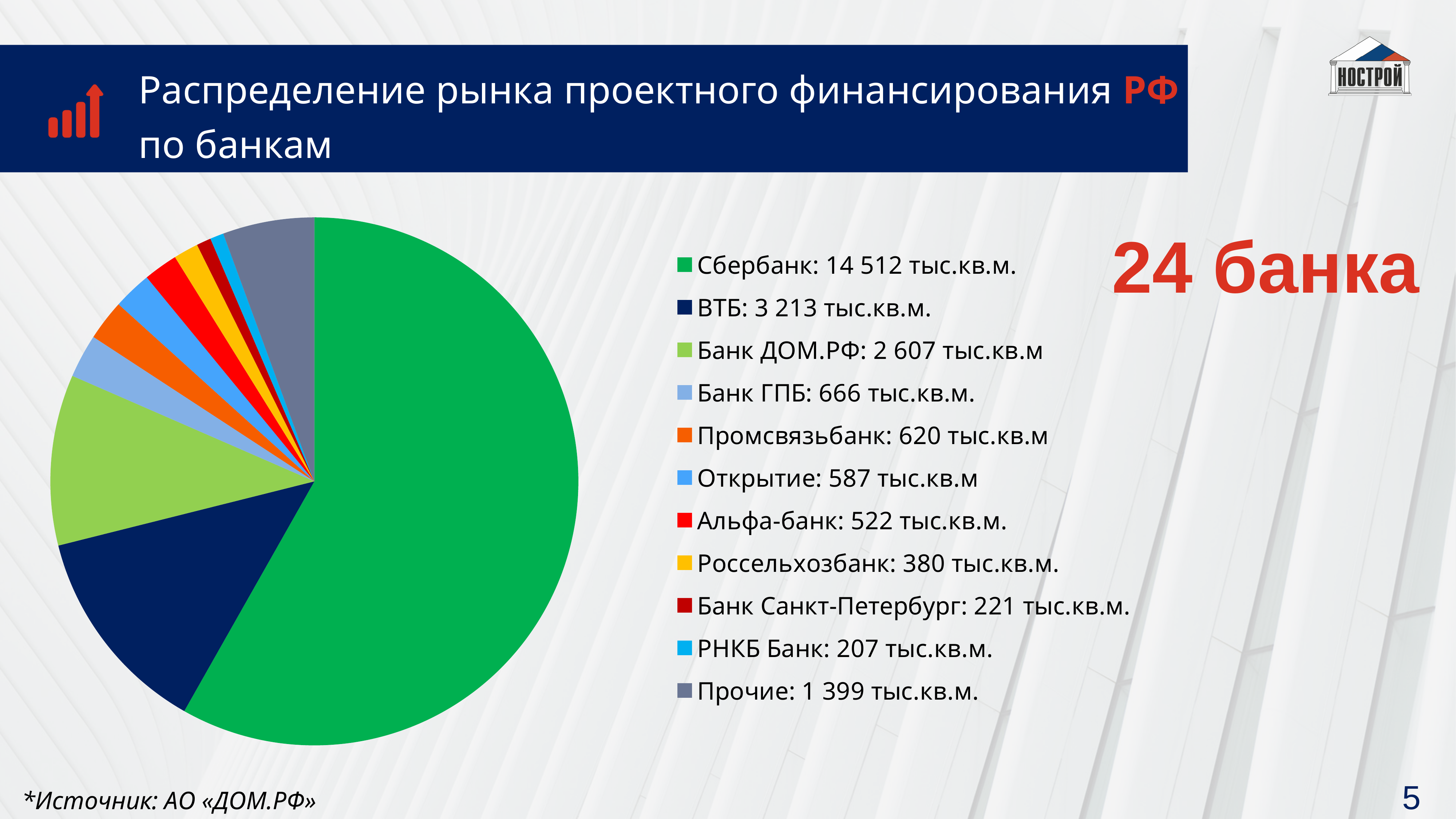
What is the value for Прочие? 1 399 тыс.кв.м. What type of chart is shown on the slide? Pie chart What is the difference between the values for Сбербанк and ВТБ? 11 299 тыс.кв.м. Which is larger, the value for Банк ГПБ or for Промсвязьбанк? Банк ГПБ What is the title of the slide containing the chart? Распределение рынка проектного финансирования РФ по банкам Which bank has the largest slice of the pie? Сбербанк What is the value for ВТБ? 3 213 тыс.кв.м. What is the difference between the values for ВТБ and Банк ДОМ.РФ? 606 тыс.кв.м. Which named bank has the smallest value in the legend? РНКБ Банк What is the value for Сбербанк? 14 512 тыс.кв.м. How many slices does the pie chart have? 11 What is the value for Банк ДОМ.РФ? 2 607 тыс.кв.м